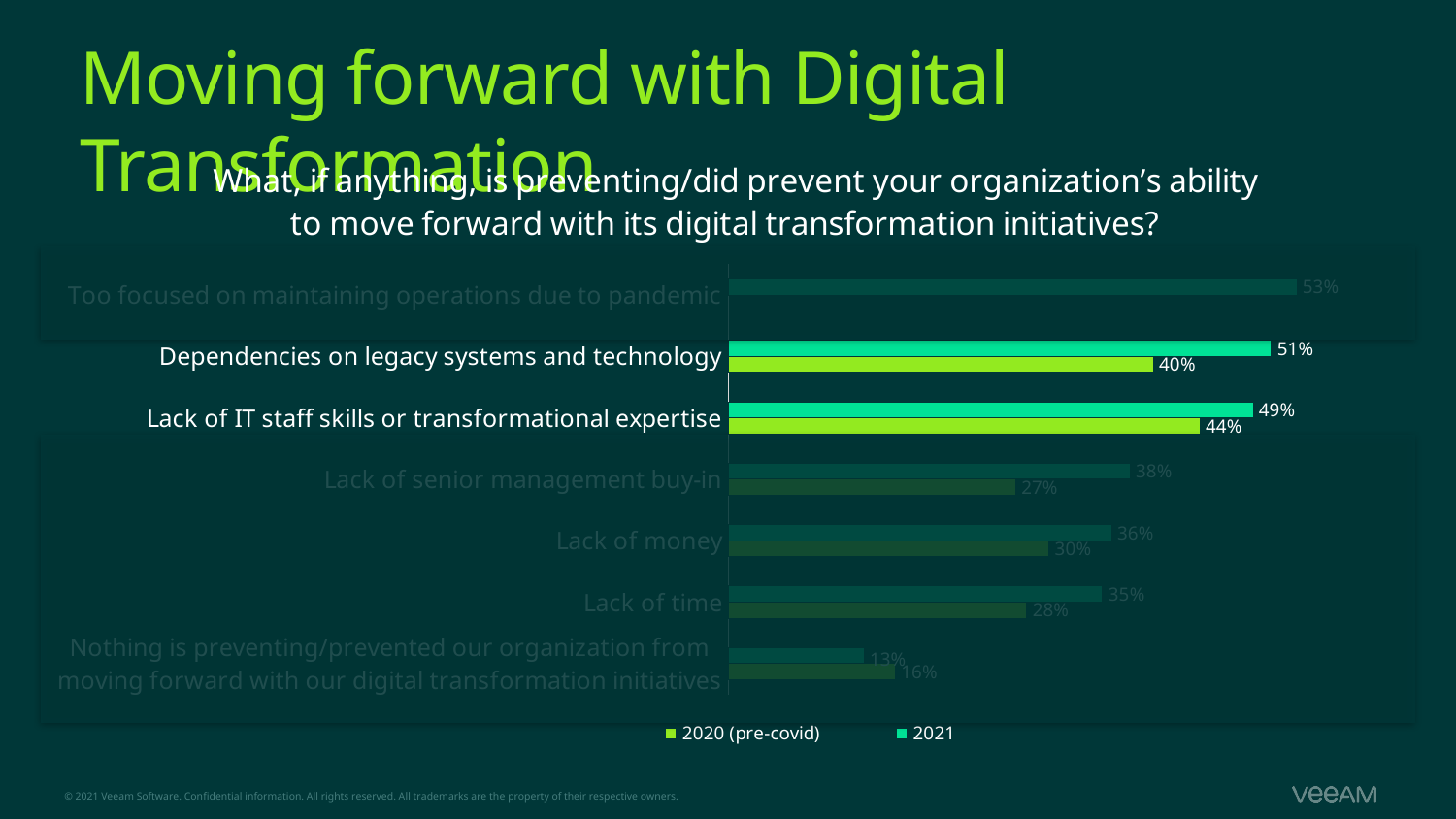
What type of chart is shown on the slide? bar chart Which category has the lowest 2020 (pre-covid) value? Nothing is preventing/prevented our organization from moving forward with our digital transformation initiatives Which category has the highest 2021 value? Too focused on maintaining operations due to pandemic What is the 2021 value for 'Dependencies on legacy systems and technology'? 51% What is the difference between the 2021 and 2020 (pre-covid) values for 'Lack of senior management buy-in'? 11% How many categories are plotted on the chart? 7 How many series does the legend list? 2 What is the 2020 (pre-covid) value for 'Lack of IT staff skills or transformational expertise'? 44% What is the 2020 (pre-covid) value for 'Lack of time'? 28% What are the two series named in the legend? 2020 (pre-covid) and 2021 For 'Lack of money', which is larger: the 2021 value or the 2020 (pre-covid) value? 2021 What is the 2021 value for 'Too focused on maintaining operations due to pandemic'? 53%